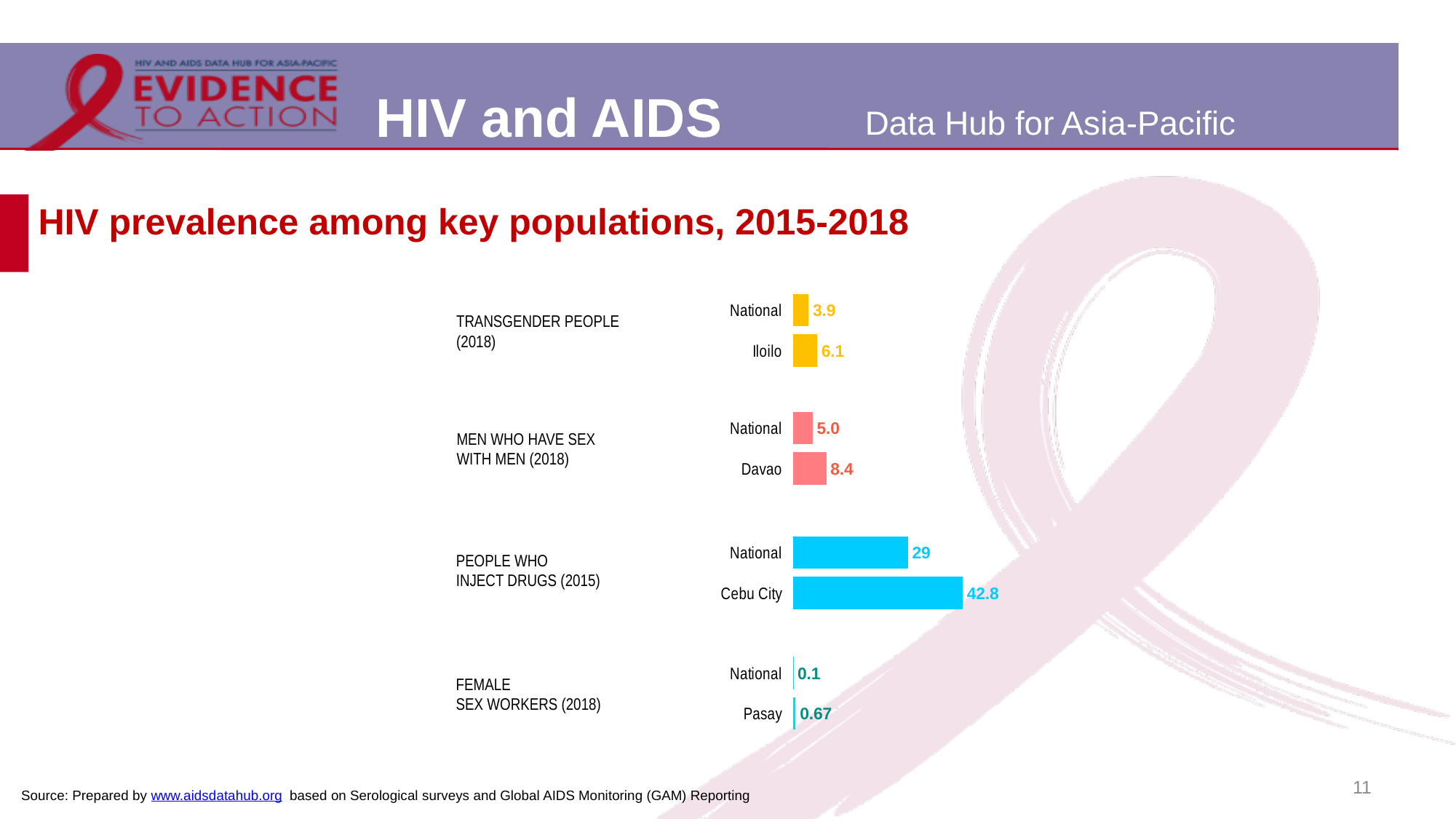
What is the HIV prevalence among people who inject drugs (2015) in Cebu City? 42.8 What is the difference between the Cebu City and national HIV prevalence among people who inject drugs (2015)? 13.8 What is the national HIV prevalence among men who have sex with men (2018)? 5.0 What is the HIV prevalence among female sex workers (2018) in Pasay? 0.67 Which bar shows the lowest HIV prevalence on the chart? National (female sex workers, 2018) What is the HIV prevalence among transgender people (2018) in Iloilo? 6.1 What is the difference between the Davao and national HIV prevalence among men who have sex with men (2018)? 3.4 Which bar shows the highest HIV prevalence on the chart? Cebu City (people who inject drugs, 2015) What is the title of the chart on the slide? HIV prevalence among key populations, 2015-2018 What type of chart is shown on the slide? Bar chart How many bars are plotted on the chart? 8 Which is larger: the national HIV prevalence among transgender people (2018) or the national prevalence among men who have sex with men (2018)? Men who have sex with men (5.0)